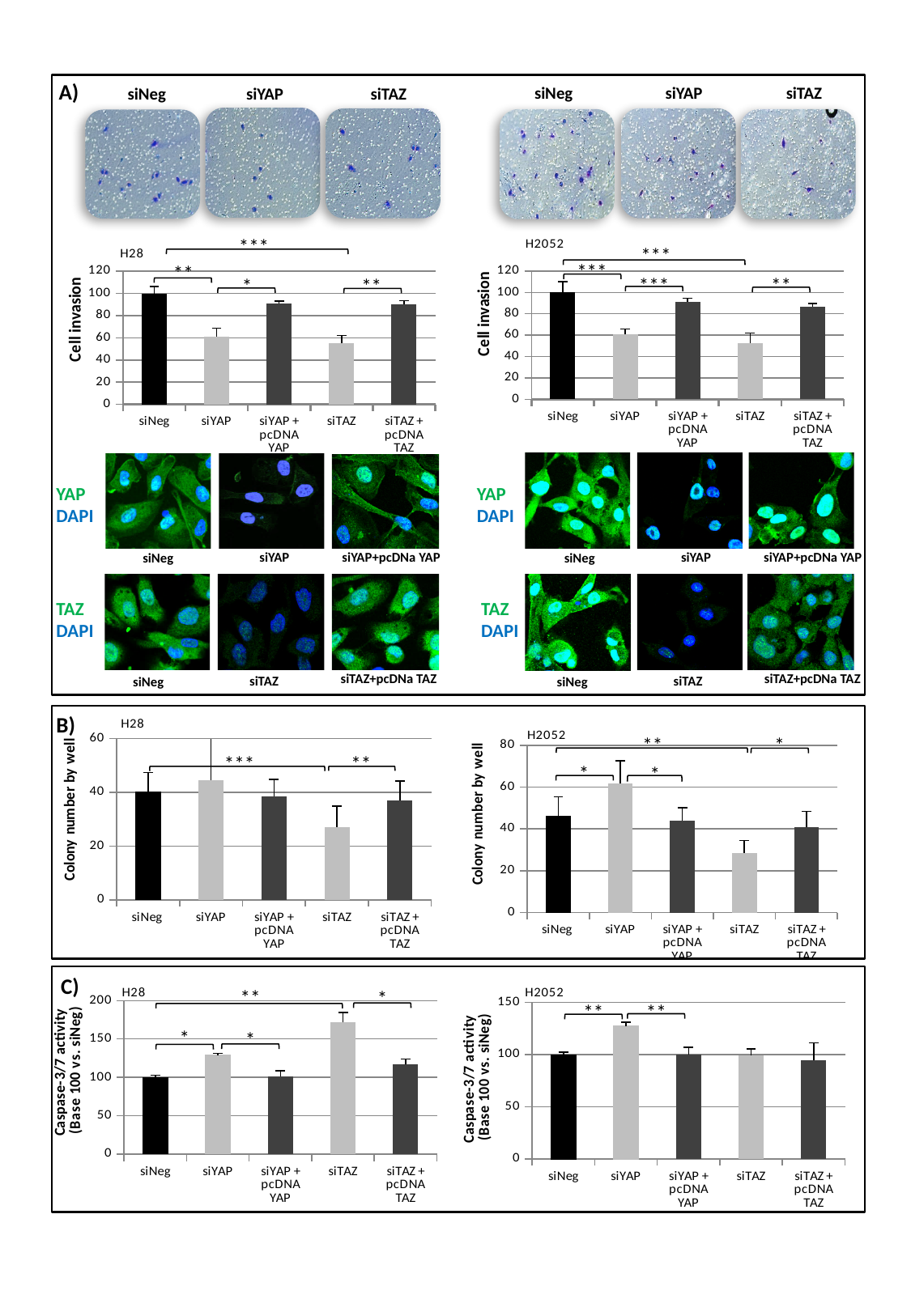
In the H28 Caspase-3/7 activity chart in panel C, is the value for siTAZ greater or less than 150? greater In the H28 Caspase-3/7 activity chart in panel C, which category has the highest value? siTAZ In the H28 Cell invasion chart in panel A, how many categories are shown on the x axis? 5 In the H2052 Cell invasion chart in panel A, which category has the highest value? siNeg What kind of chart is the H28 Cell invasion chart in panel A? bar chart In the H2052 Colony number by well chart in panel B, is the value for siTAZ greater or less than 40? less What is the y-axis title of the charts in panel B? Colony number by well In the H2052 Colony number by well chart in panel B, which is larger, the value for siYAP or the value for siTAZ? siYAP In the H28 Cell invasion chart in panel A, what is the value for siNeg? 100 In the H2052 Caspase-3/7 activity chart in panel C, what is the value for siNeg? 100 In the H28 Colony number by well chart in panel B, which category has the lowest value? siTAZ In the H28 Cell invasion chart in panel A, is the value for siYAP greater or less than 80? less